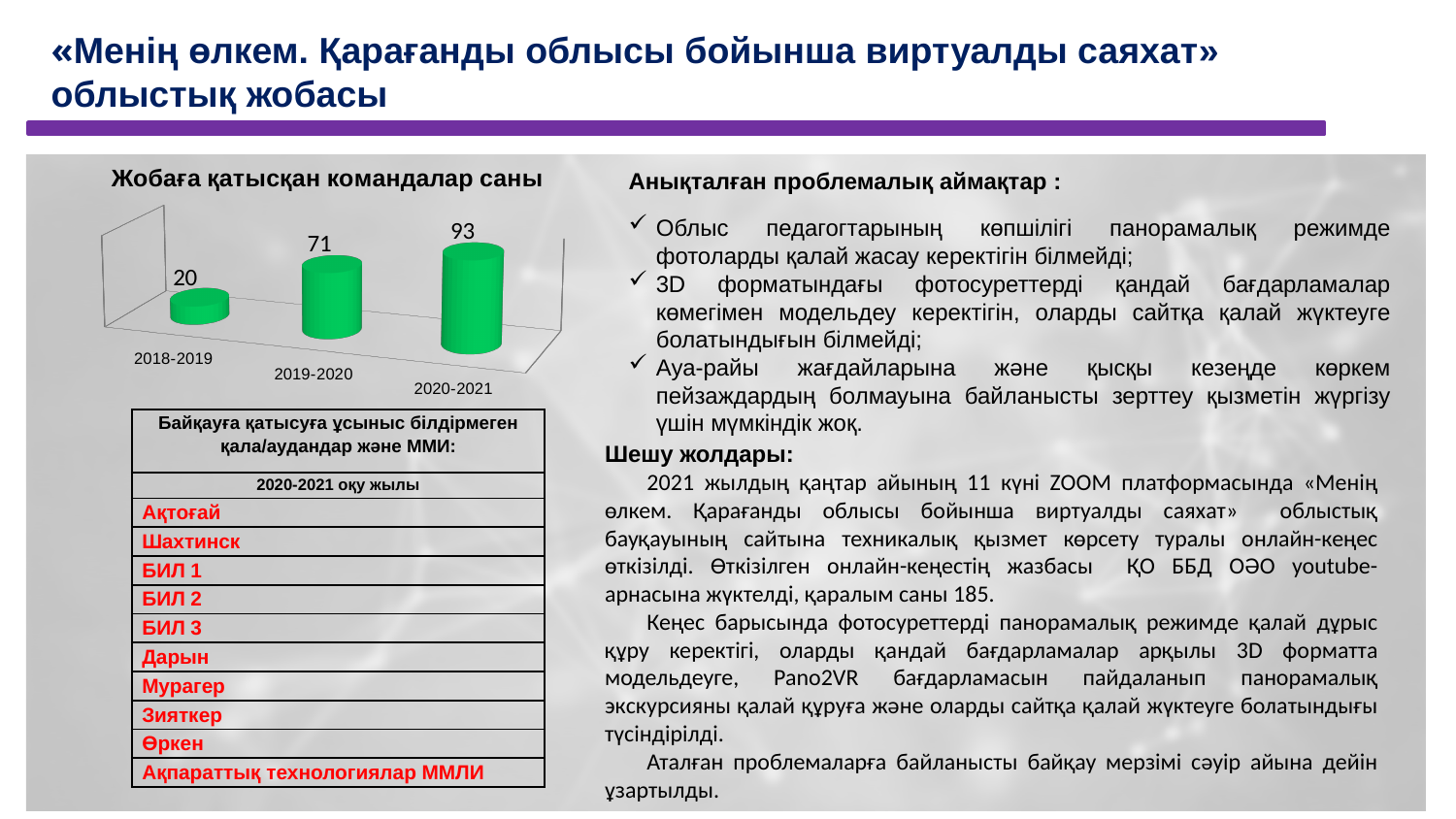
What is the value for 2019-2020 in the chart? 71 Which is larger, the value for 2019-2020 or the value for 2018-2019? 2019-2020 What is the difference between the values for 2019-2020 and 2018-2019? 51 Do the values rise or fall from 2018-2019 to 2020-2021? Rise Which category has the lowest value in the chart? 2018-2019 What kind of chart is shown on the slide? Bar chart What is the difference between the values for 2020-2021 and 2019-2020? 22 What is the value for 2020-2021 in the chart? 93 Which category has the highest value in the chart? 2020-2021 What is the title of the chart? Жобаға қатысқан командалар саны What is the value for 2018-2019 in the chart? 20 How many categories are shown in the chart? 3